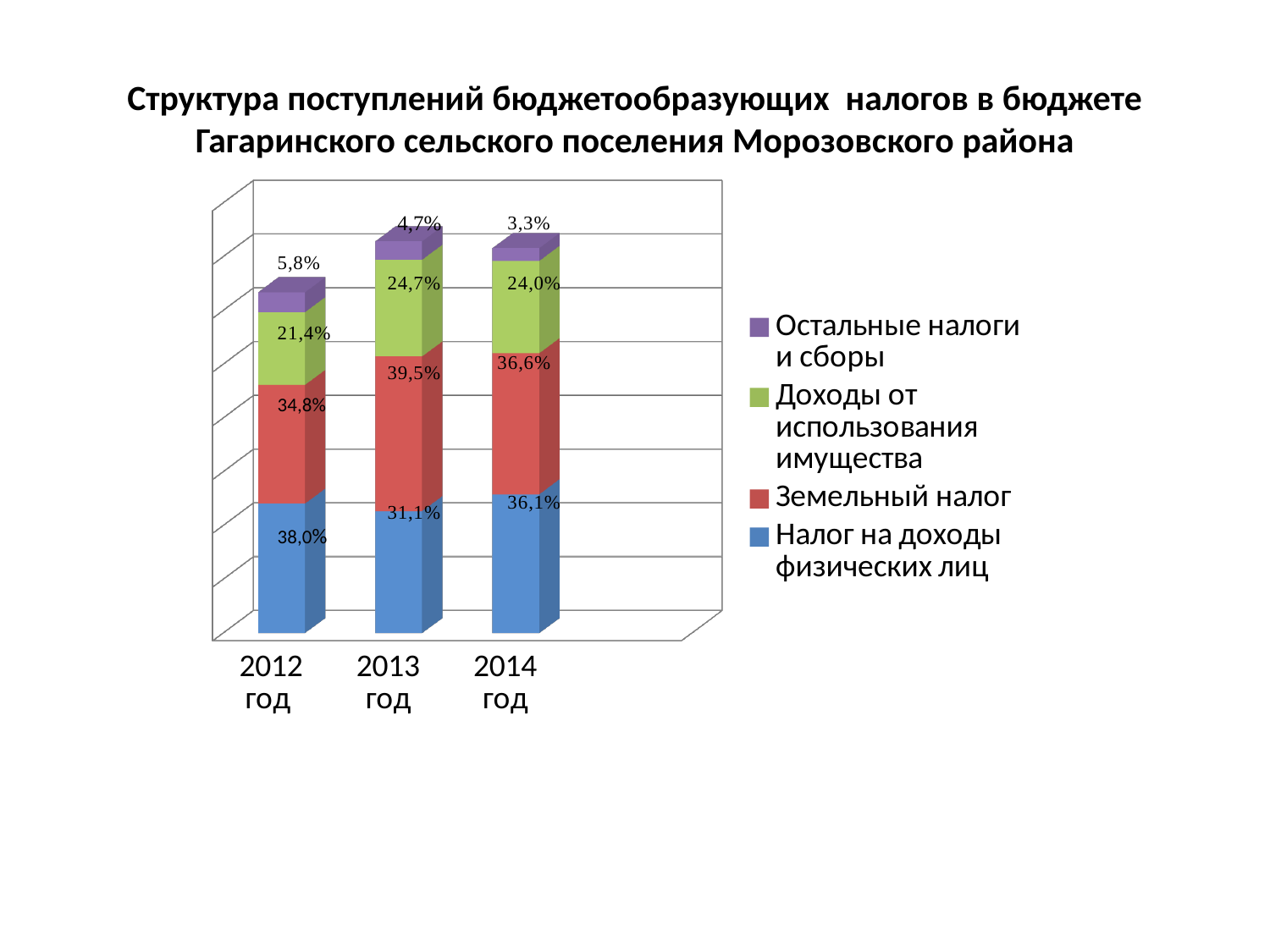
What is the value of Налог на доходы физических лиц for 2012 год? 38,0% How many years (categories) are shown on the x axis? 3 What is the value of Остальные налоги и сборы for 2014 год? 3,3% What is the value of Земельный налог for 2013 год? 39,5% In which year is Земельный налог the highest? 2013 год How many series does the legend list? 4 In which year is Остальные налоги и сборы the lowest? 2014 год What is the value of Доходы от использования имущества for 2014 год? 24,0% What type of chart is shown on the slide? Stacked bar chart What is the difference between Налог на доходы физических лиц in 2012 год and 2013 год? 6,9% Which is larger in 2014 год: Земельный налог or Налог на доходы физических лиц? Земельный налог Does the value of Остальные налоги и сборы rise or fall from 2012 год to 2014 год? Fall